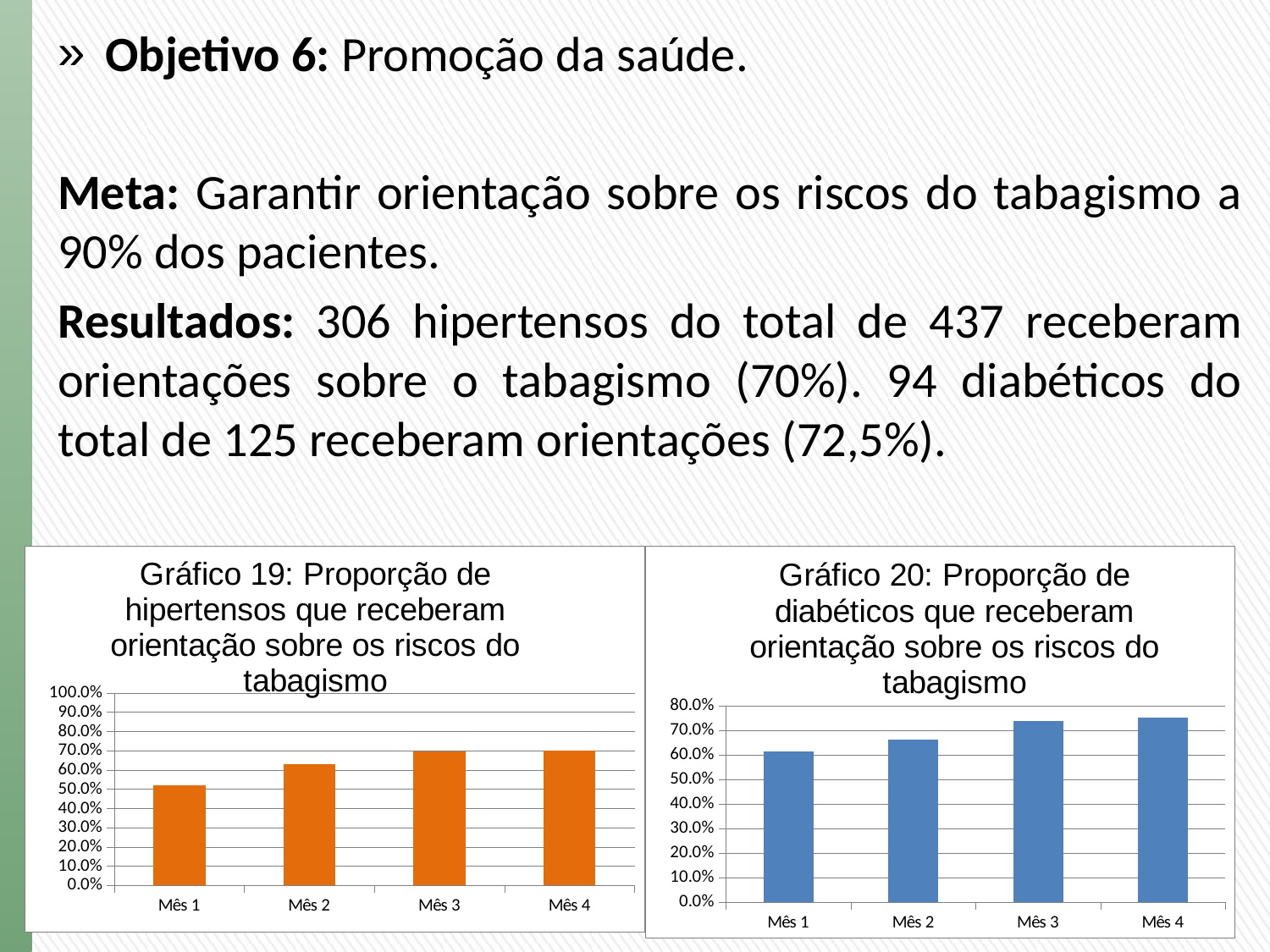
In Gráfico 19, is the value for Mês 1 greater or less than 60.0%? less How many categories are shown on the x axis of Gráfico 20? 4 In Gráfico 20, is the value for Mês 2 greater or less than 70.0%? less What is the title of the chart on the right of the slide? Gráfico 20: Proporção de diabéticos que receberam orientação sobre os riscos do tabagismo In Gráfico 20, is the value for Mês 4 greater or less than 70.0%? greater In Gráfico 19, which month has the lowest proportion? Mês 1 What kind of chart is Gráfico 19? bar chart In Gráfico 20, which is larger, the value for Mês 2 or the value for Mês 3? Mês 3 In Gráfico 20, do the values rise or fall from Mês 1 to Mês 4? rise In Gráfico 20, which month has the lowest proportion? Mês 1 In Gráfico 19, which is larger, the value for Mês 1 or the value for Mês 2? Mês 2